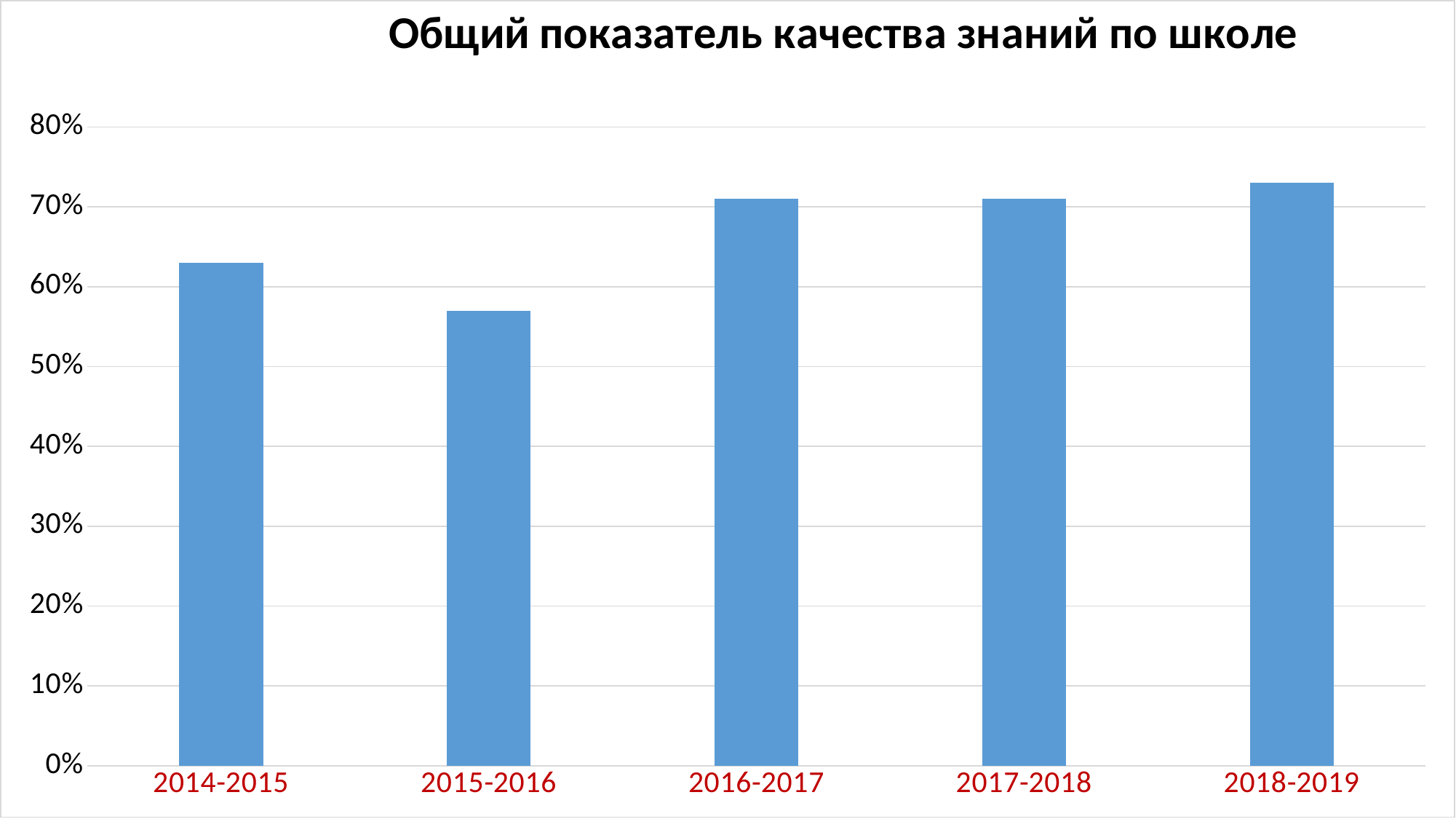
Which school year has the highest value? 2018-2019 Which is larger, the value for 2018-2019 or the value for 2014-2015? 2018-2019 Is the value for 2015-2016 greater or less than 60%? less Which school year has the lowest value? 2015-2016 What kind of chart is shown on the slide? bar chart Which is larger, the value for 2014-2015 or the value for 2015-2016? 2014-2015 What is the title of the chart? Общий показатель качества знаний по школе How many school years are shown on the x axis? 5 Does the value rise or fall from 2015-2016 to 2016-2017? rise Is the value for 2018-2019 greater or less than 70%? greater Is the value for 2017-2018 greater or less than 80%? less